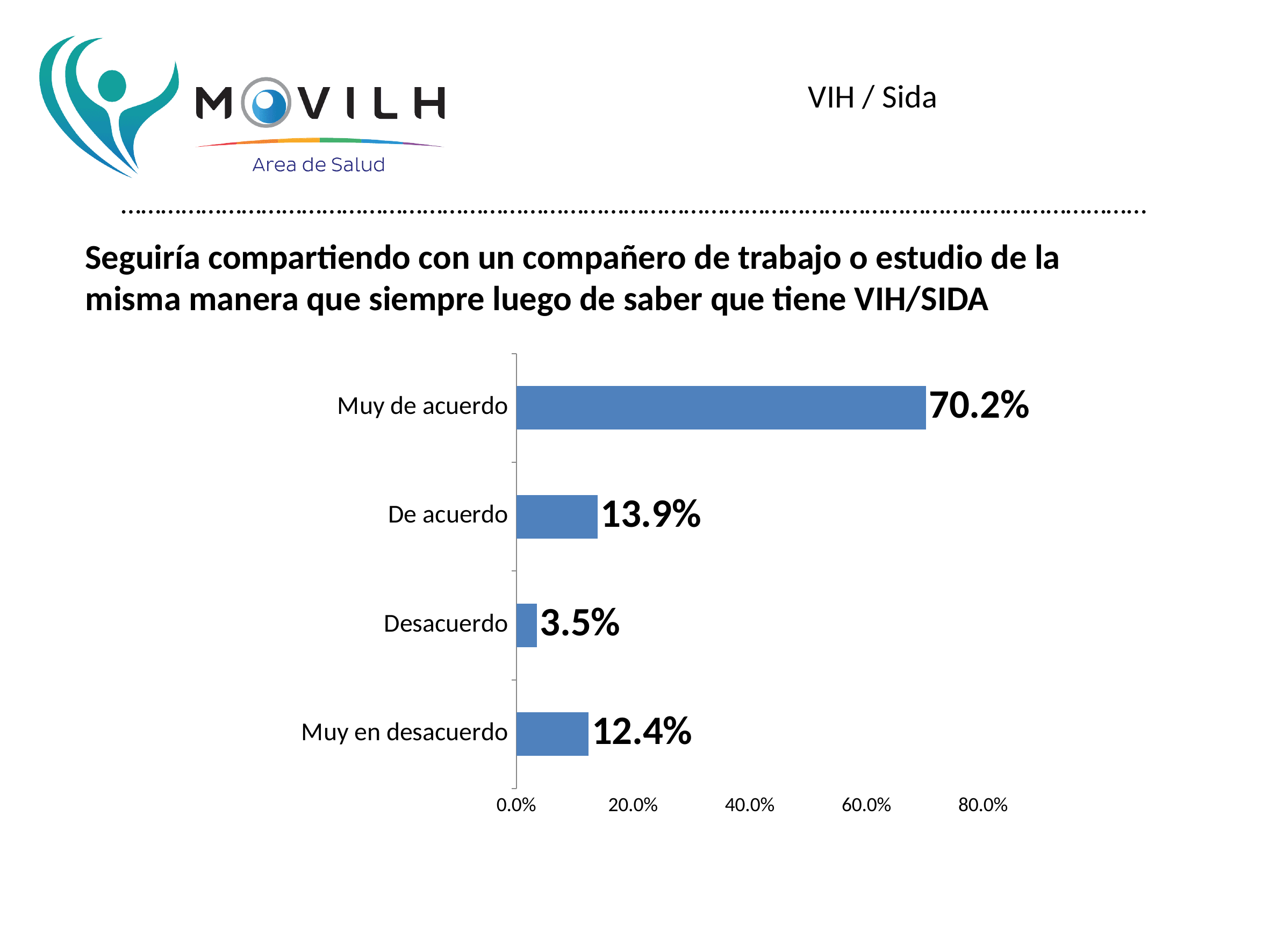
What is the difference between the values for "Muy de acuerdo" and "De acuerdo"? 56.3% Is the value for "Muy de acuerdo" greater or less than 60.0%? greater Which is larger, the value for "De acuerdo" or the value for "Muy en desacuerdo"? De acuerdo What is the value for "Muy en desacuerdo"? 12.4% What is the highest value shown on the x axis? 80.0% Which category has the highest value? Muy de acuerdo Which category has the lowest value? Desacuerdo What is the value for "De acuerdo"? 13.9% What is the value for "Muy de acuerdo"? 70.2% What kind of chart is shown on the slide? bar chart How many categories are shown in the chart? 4 What is the value for "Desacuerdo"? 3.5%